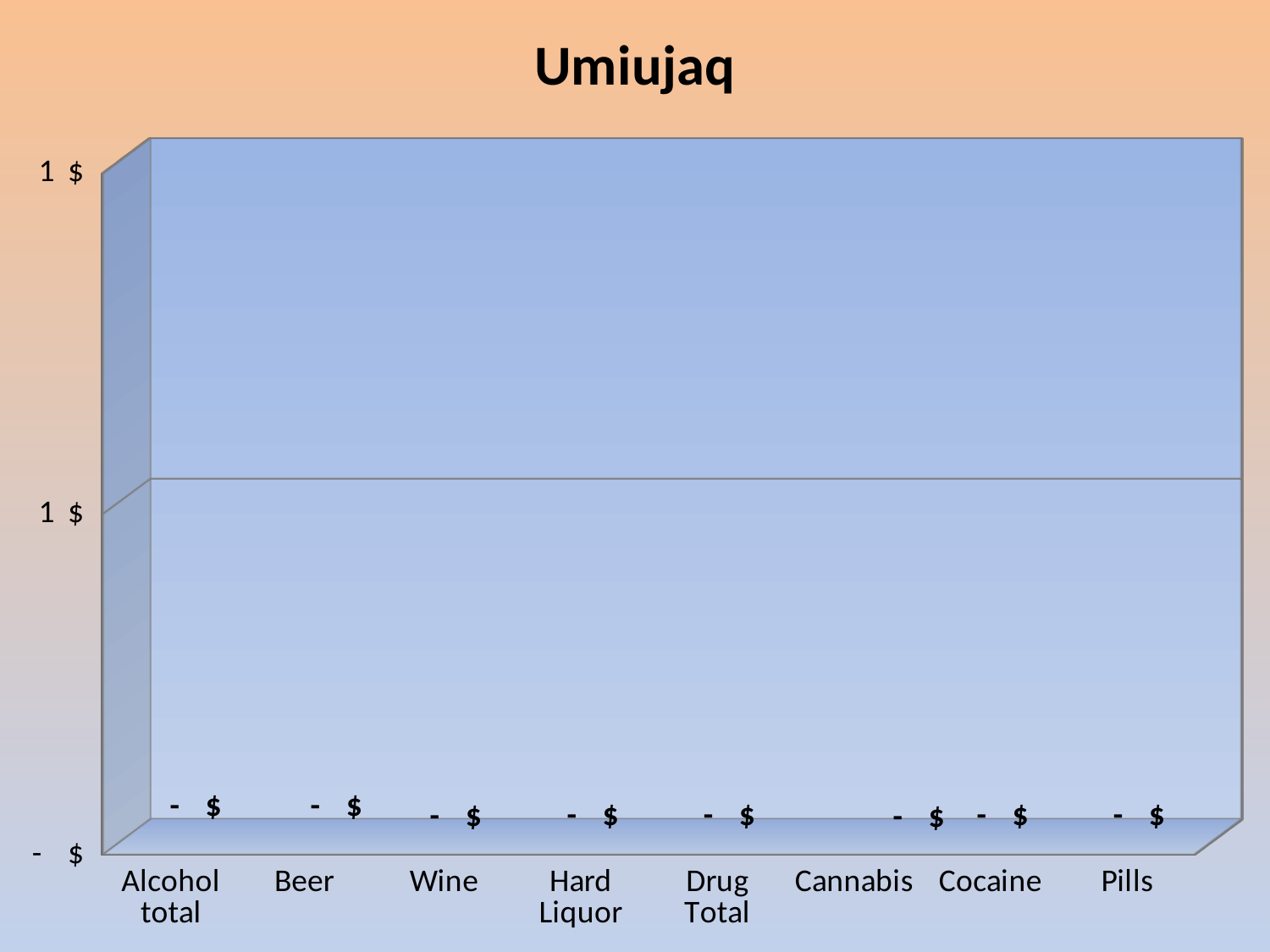
What value is labelled for Beer in the chart? - $ Is the value for Cocaine greater or less than 1 $? less What value is labelled for Cannabis in the chart? - $ What value is labelled for Alcohol total in the chart? - $ How many categories are shown on the x axis of the chart? 8 What kind of chart is shown on the slide? bar chart What is the first category label on the x axis of the chart? Alcohol total What is the title of the chart? Umiujaq Is the value for Drug Total greater or less than 1 $? less What value is labelled for Pills in the chart? - $